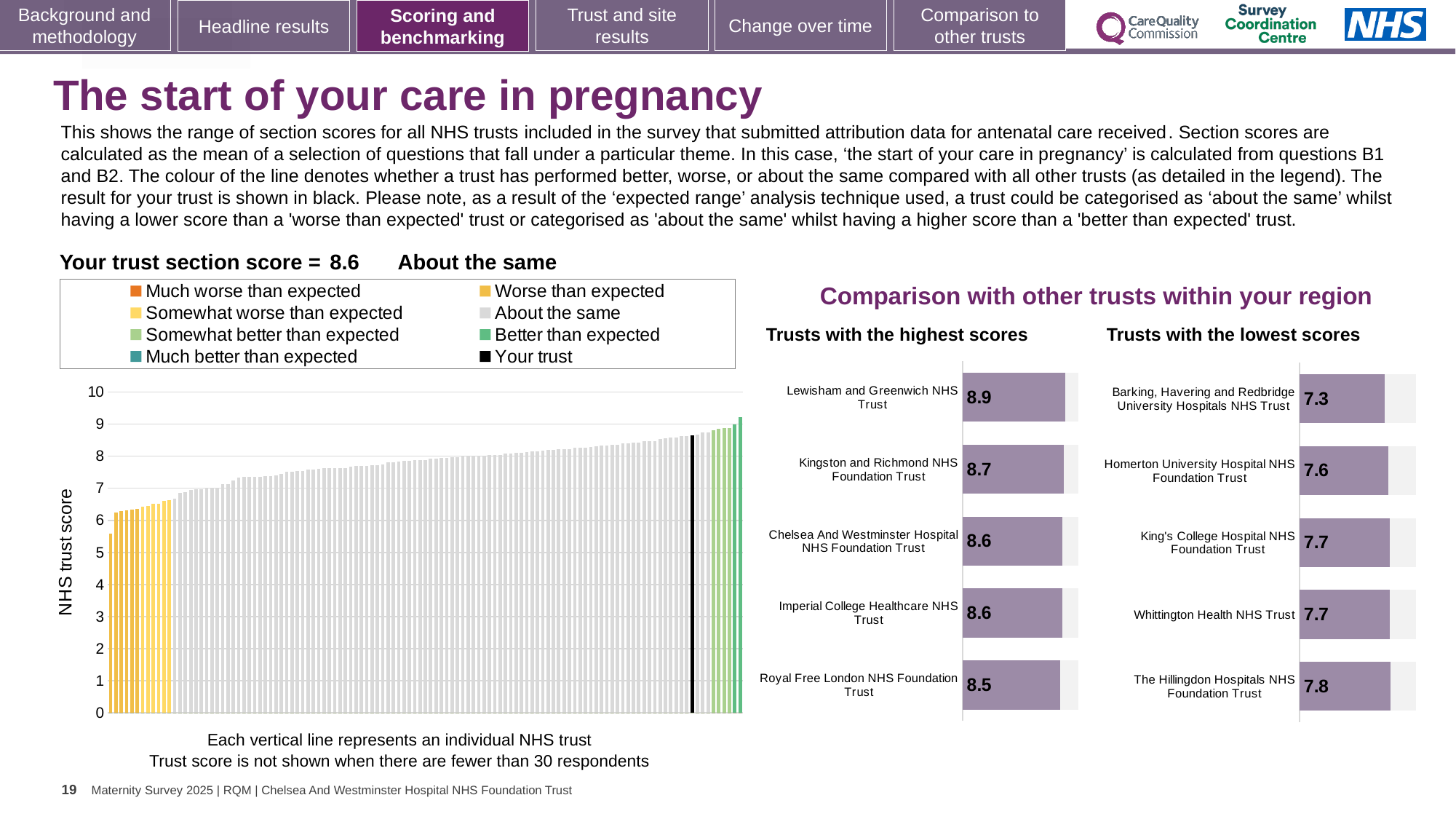
In the 'Trusts with the lowest scores' chart, which trust has the lowest score? Barking, Havering and Redbridge University Hospitals NHS Trust In the large 'NHS trust score' chart on the left, do the bar values rise or fall from left to right? rise In the 'Trusts with the highest scores' chart, what is the score for Lewisham and Greenwich NHS Trust? 8.9 In the 'Trusts with the highest scores' chart, which trust has the highest score? Lewisham and Greenwich NHS Trust What kind of chart is the large 'NHS trust score' chart on the left? bar chart In the 'Trusts with the highest scores' chart, what is the difference between the scores of Lewisham and Greenwich NHS Trust and Royal Free London NHS Foundation Trust? 0.4 In the 'Trusts with the lowest scores' chart, which has the larger score: Homerton University Hospital NHS Foundation Trust or The Hillingdon Hospitals NHS Foundation Trust? The Hillingdon Hospitals NHS Foundation Trust How many entries does the legend above the large 'NHS trust score' chart list? 8 In the 'Trusts with the lowest scores' chart, what is the score for Homerton University Hospital NHS Foundation Trust? 7.6 In the 'Trusts with the lowest scores' chart, what is the difference between the scores of The Hillingdon Hospitals NHS Foundation Trust and Barking, Havering and Redbridge University Hospitals NHS Trust? 0.5 How many trusts are listed in the 'Trusts with the highest scores' chart? 5 In the large 'NHS trust score' chart on the left, is the value of the lowest bar greater or less than 6? less